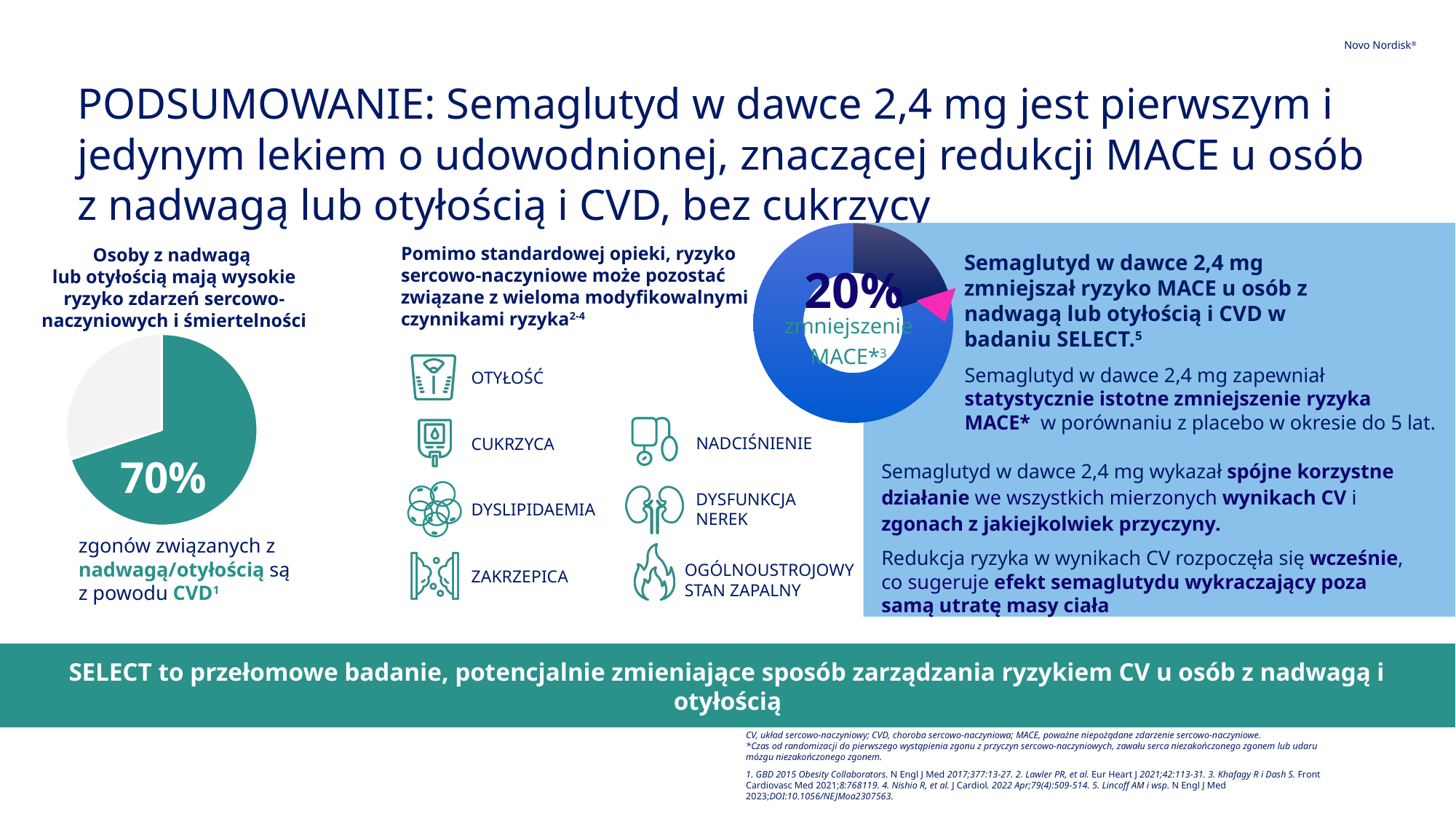
In the left pie chart, which slice is larger: the green slice or the grey slice? the green slice What colour is the slice labelled 70% in the left pie chart? green According to the donut chart in the middle of the slide, by how much did semaglutide 2.4 mg reduce MACE? 20% In the left pie chart, what share of deaths related to overweight/obesity is attributed to CVD? 70% In the left pie chart, what percentage is printed on the large green slice? 70% How many slices does the left pie chart have? 2 What percentage is printed in the centre of the donut chart in the middle of the slide? 20% What text appears below the 20% figure in the middle donut chart? zmniejszenie MACE* Is the value shown in the middle donut chart greater or less than 50%? less What kind of chart is shown on the left of the slide, below the text about people with overweight or obesity? pie chart In the left pie chart, is the value of the green slice greater or less than 50%? greater